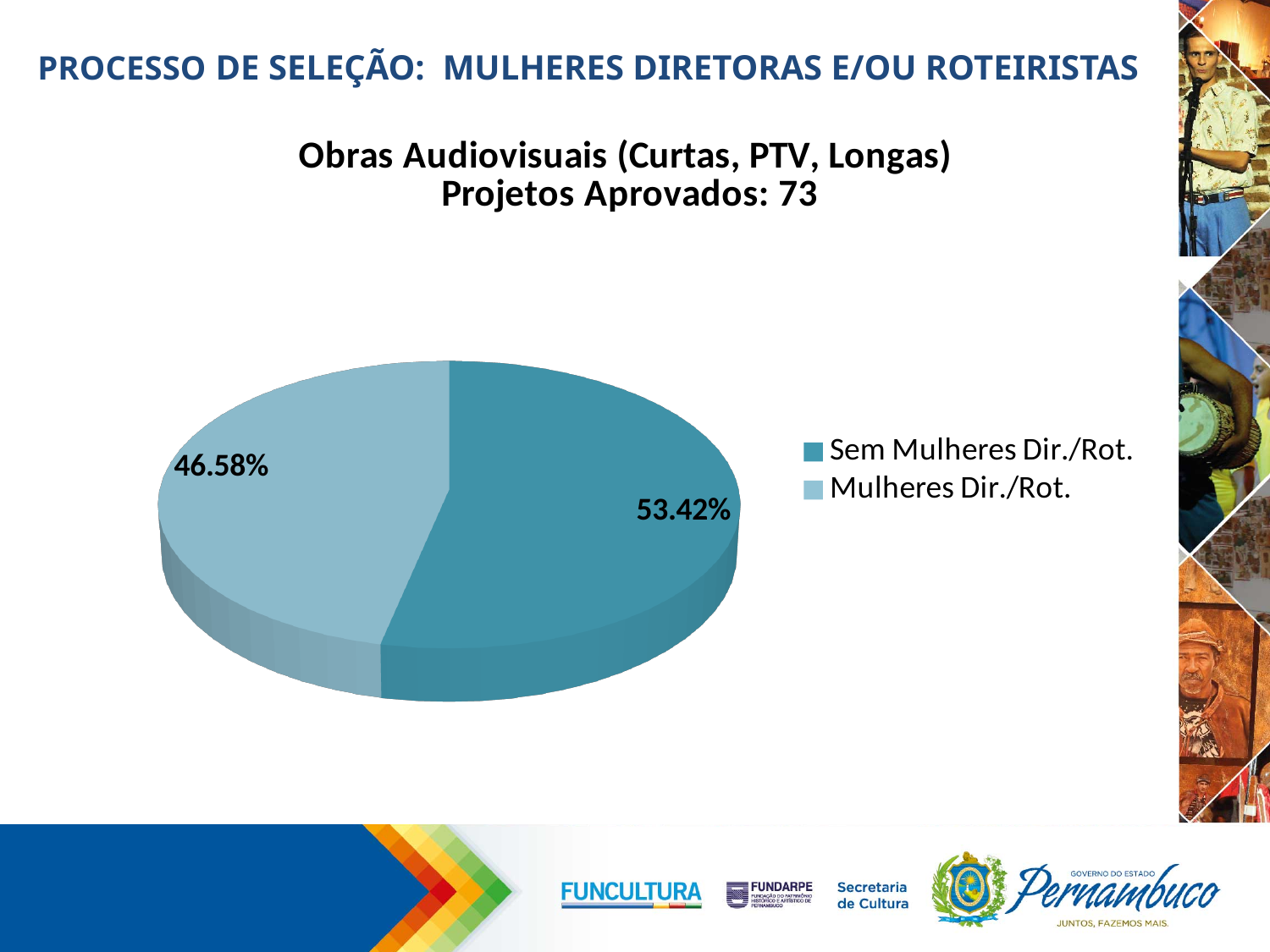
Which slice of the pie is the smallest? Mulheres Dir./Rot. Which is larger: the share for "Mulheres Dir./Rot." or the share for "Sem Mulheres Dir./Rot."? Sem Mulheres Dir./Rot. Which legend entry is shown in the lighter blue colour? Mulheres Dir./Rot. According to the chart title, how many projects were approved (Projetos Aprovados)? 73 What kind of chart is shown on the slide? Pie chart Is the share for "Mulheres Dir./Rot." greater or less than 50%? less What share of the pie does "Sem Mulheres Dir./Rot." represent? 53.42% How many entries does the legend list? 2 What share of the pie does "Mulheres Dir./Rot." represent? 46.58% How many slices does the pie chart have? 2 Which slice of the pie is the largest? Sem Mulheres Dir./Rot. What is the difference in percentage points between the "Sem Mulheres Dir./Rot." slice and the "Mulheres Dir./Rot." slice? 6.84 percentage points